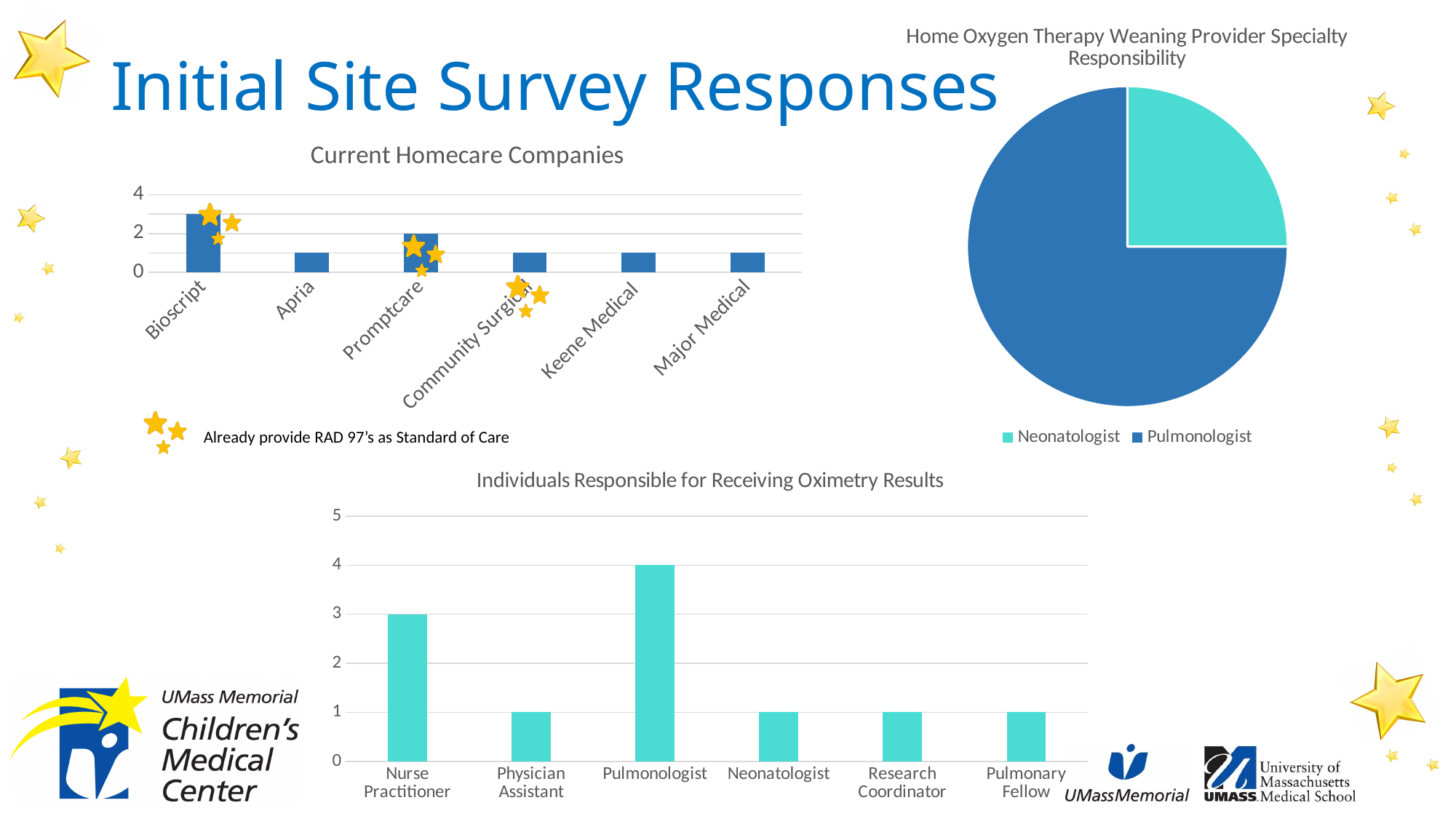
In the 'Individuals Responsible for Receiving Oximetry Results' chart, which category has the highest value? Pulmonologist In the 'Current Homecare Companies' chart, how many companies are shown on the x axis? 6 In the 'Current Homecare Companies' chart, what is the value for Promptcare? 2 What kind of chart is 'Home Oxygen Therapy Weaning Provider Specialty Responsibility'? pie chart In the 'Current Homecare Companies' chart, which company has the highest value? Bioscript In the 'Individuals Responsible for Receiving Oximetry Results' chart, what is the value for Pulmonologist? 4 In the 'Current Homecare Companies' chart, what is the value for Bioscript? 3 In the 'Individuals Responsible for Receiving Oximetry Results' chart, what is the value for Nurse Practitioner? 3 How many entries does the legend of the 'Home Oxygen Therapy Weaning Provider Specialty Responsibility' pie chart list? 2 In the 'Home Oxygen Therapy Weaning Provider Specialty Responsibility' pie chart, which slice is larger, Neonatologist or Pulmonologist? Pulmonologist In the 'Individuals Responsible for Receiving Oximetry Results' chart, how many categories are shown on the x axis? 6 In the 'Current Homecare Companies' chart, what is the difference between the values for Bioscript and Apria? 2